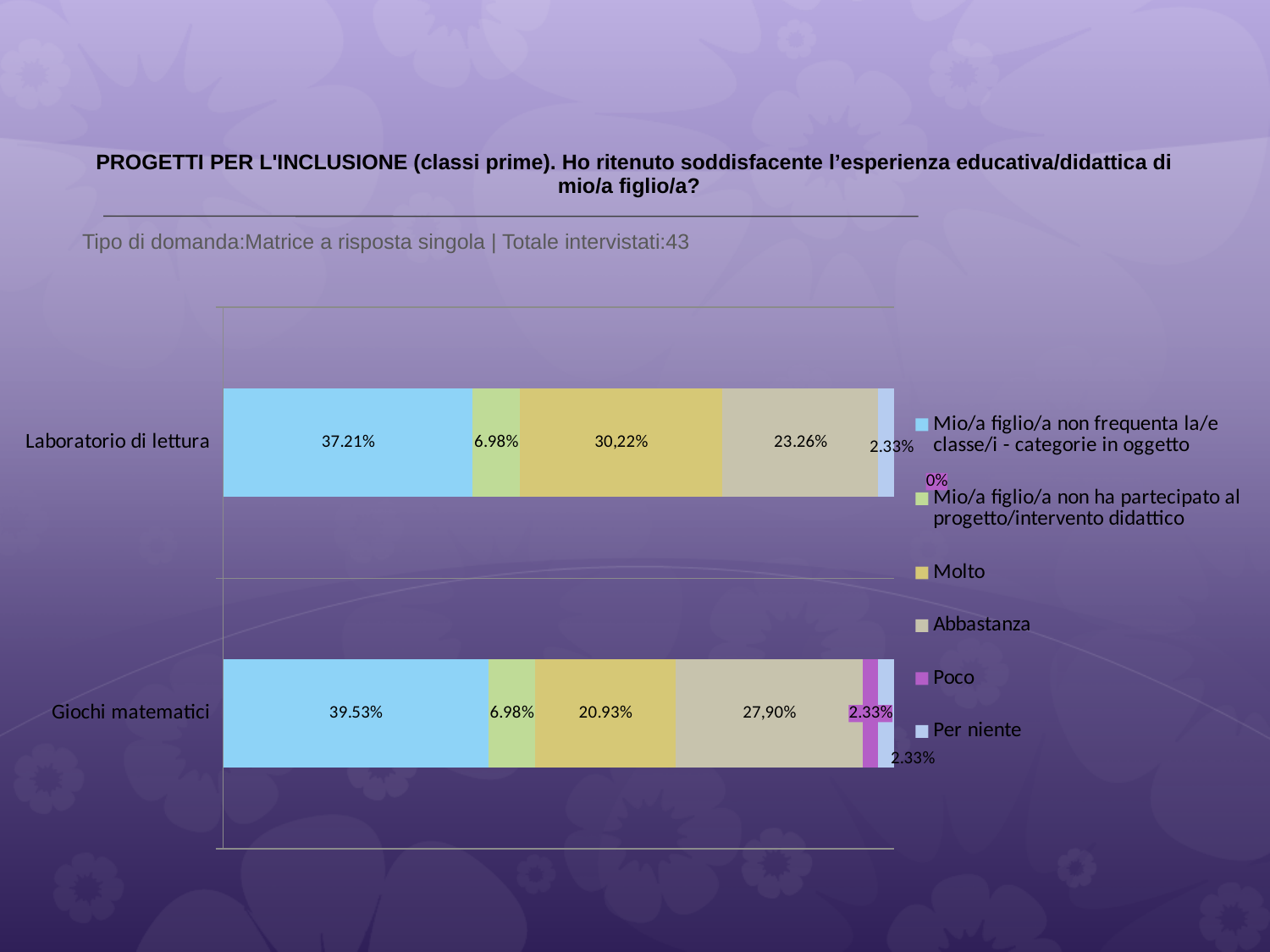
What is the value of 'Mio/a figlio/a non frequenta la/e classe/i - categorie in oggetto' for Laboratorio di lettura? 37.21% What is the value of 'Molto' for Giochi matematici? 20.93% What is the value of 'Molto' for Laboratorio di lettura? 30,22% What kind of chart is shown on the slide? stacked bar chart What is the value of 'Abbastanza' for Giochi matematici? 27,90% What is the value of 'Poco' for Laboratorio di lettura? 0% Which series is shown in the purple colour in the legend? Poco What is the difference between the 'Molto' values for Laboratorio di lettura and Giochi matematici? 9.29% What is the value of 'Abbastanza' for Laboratorio di lettura? 23.26% How many series does the legend list? 6 Which category has the higher value for 'Mio/a figlio/a non frequenta la/e classe/i - categorie in oggetto', Laboratorio di lettura or Giochi matematici? Giochi matematici How many categories are plotted on the chart? 2